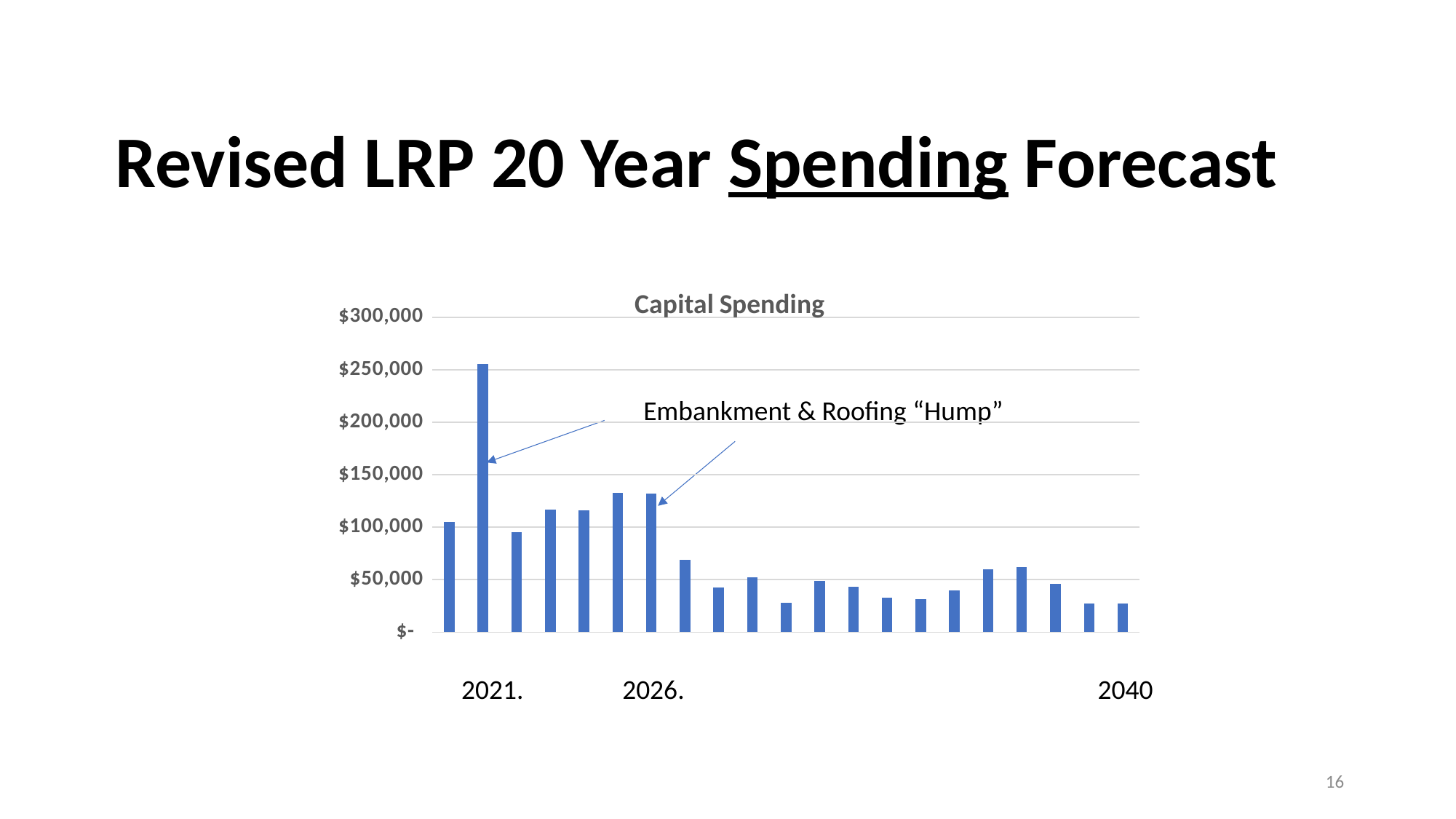
Is the value of the last bar (2040) in the Capital Spending chart greater or less than $50,000? less What text does the annotation with arrows on the chart say? Embankment & Roofing "Hump" Is the value of the tallest bar in the Capital Spending chart greater or less than $200,000? greater What is the highest value shown on the vertical axis of the Capital Spending chart? $300,000 Which is larger in the Capital Spending chart, the first bar (2021) or the last bar (2040)? the first bar (2021) Is the value of the tallest bar in the Capital Spending chart greater or less than $300,000? less What kind of chart is shown on the slide? bar chart Overall, do the values in the Capital Spending chart rise or fall from 2021 to 2040? fall What is the title of the chart? Capital Spending